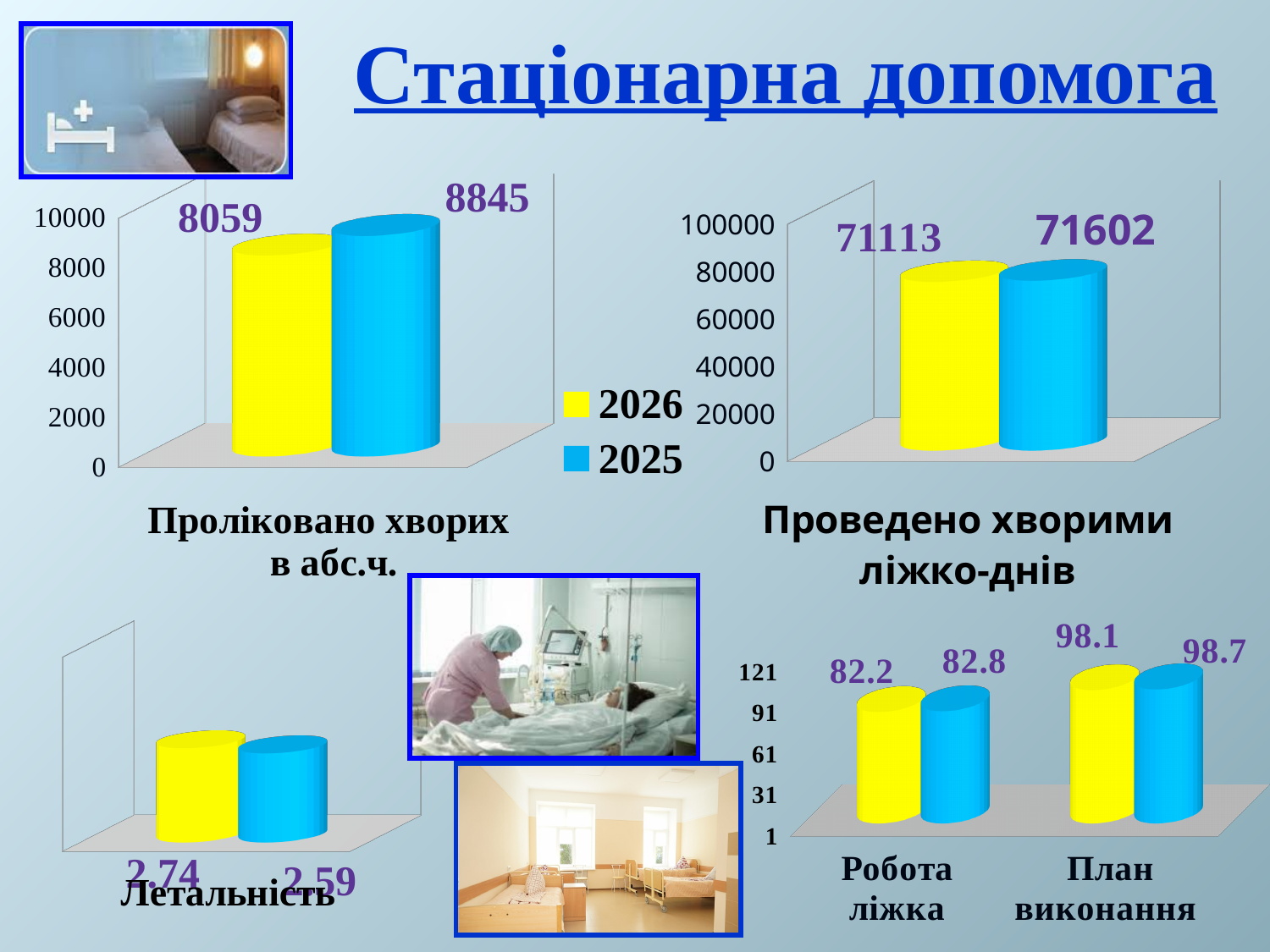
In the chart titled "Проліковано хворих в абс.ч.", what is the value for 2025? 8845 In the chart titled "Проліковано хворих в абс.ч.", what is the difference between the 2025 and 2026 values? 786 In the bottom-right chart, how many categories are shown on the x axis? 2 In the chart titled "Проведено хворими ліжко-днів", what is the value for 2025? 71602 In the chart titled "Проведено хворими ліжко-днів", which year has the larger value, 2025 or 2026? 2025 In the bottom-right chart, what is the 2025 value for "План виконання"? 98.7 In the bottom-right chart, what is the 2026 value for "Робота ліжка"? 82.2 In the chart titled "Проведено хворими ліжко-днів", what is the value for 2026? 71113 How many series does the shared legend list? 2 In the chart titled "Летальність", what is the value for 2026? 2.74 In the chart titled "Летальність", what is the value for 2025? 2.59 In the chart titled "Проліковано хворих в абс.ч.", what is the value for 2026? 8059